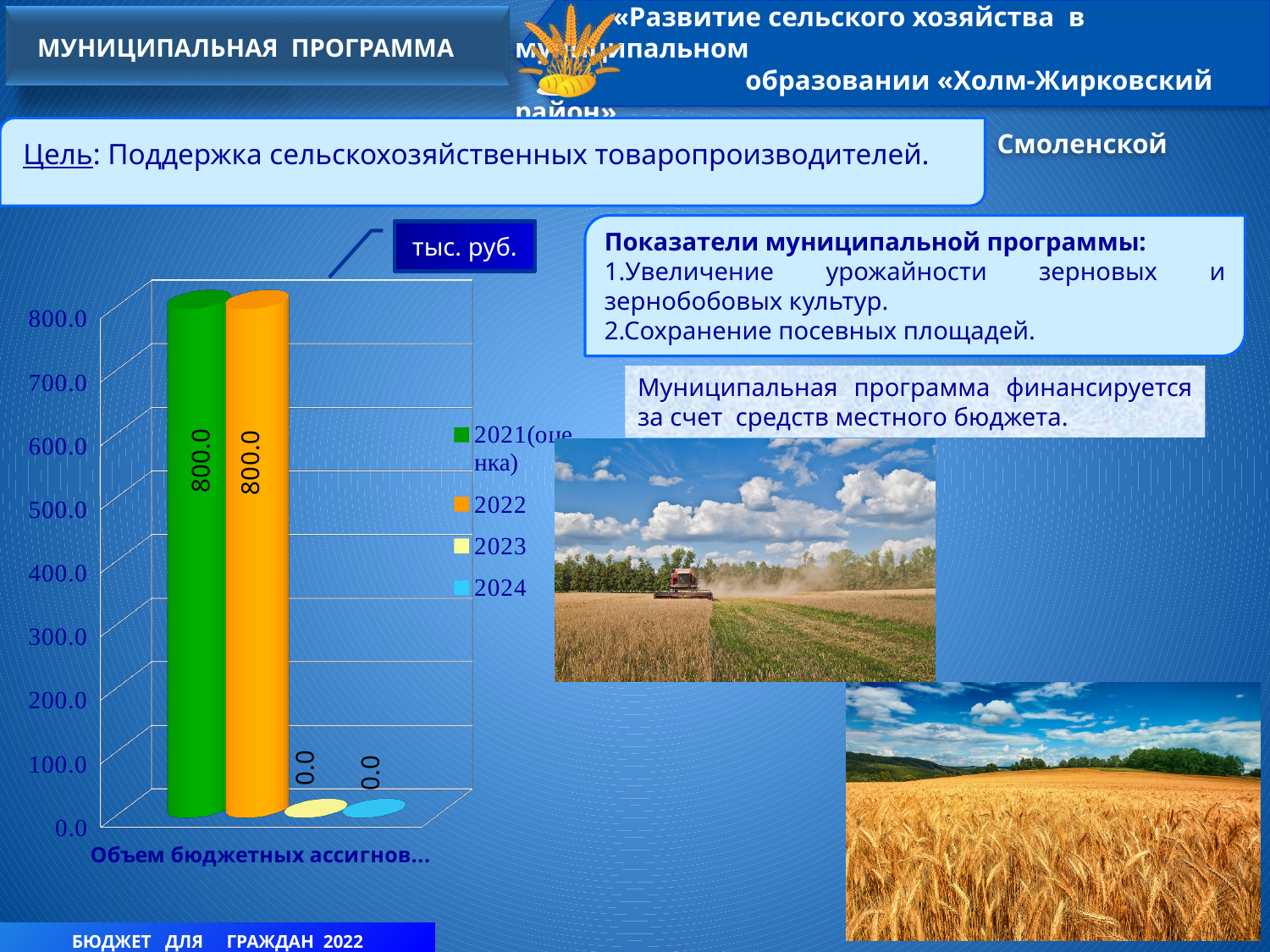
What colour is the bar for the 2022 series? orange What is the difference between the values for 2022 and 2023? 800.0 What is the value for the 2024 series in the chart? 0.0 Is the value for 2022 greater or less than 500.0? greater What is the value for the 2023 series in the chart? 0.0 What is the value for the 2021(оценка) series in the chart? 800.0 Which is larger, the value for 2022 or the value for 2024? 2022 Is the value for 2023 greater or less than 100.0? less How many series does the chart legend list? 4 What kind of chart is shown on the slide? bar chart What unit is shown in the label above the chart? тыс. руб. What is the value for the 2022 series in the chart? 800.0